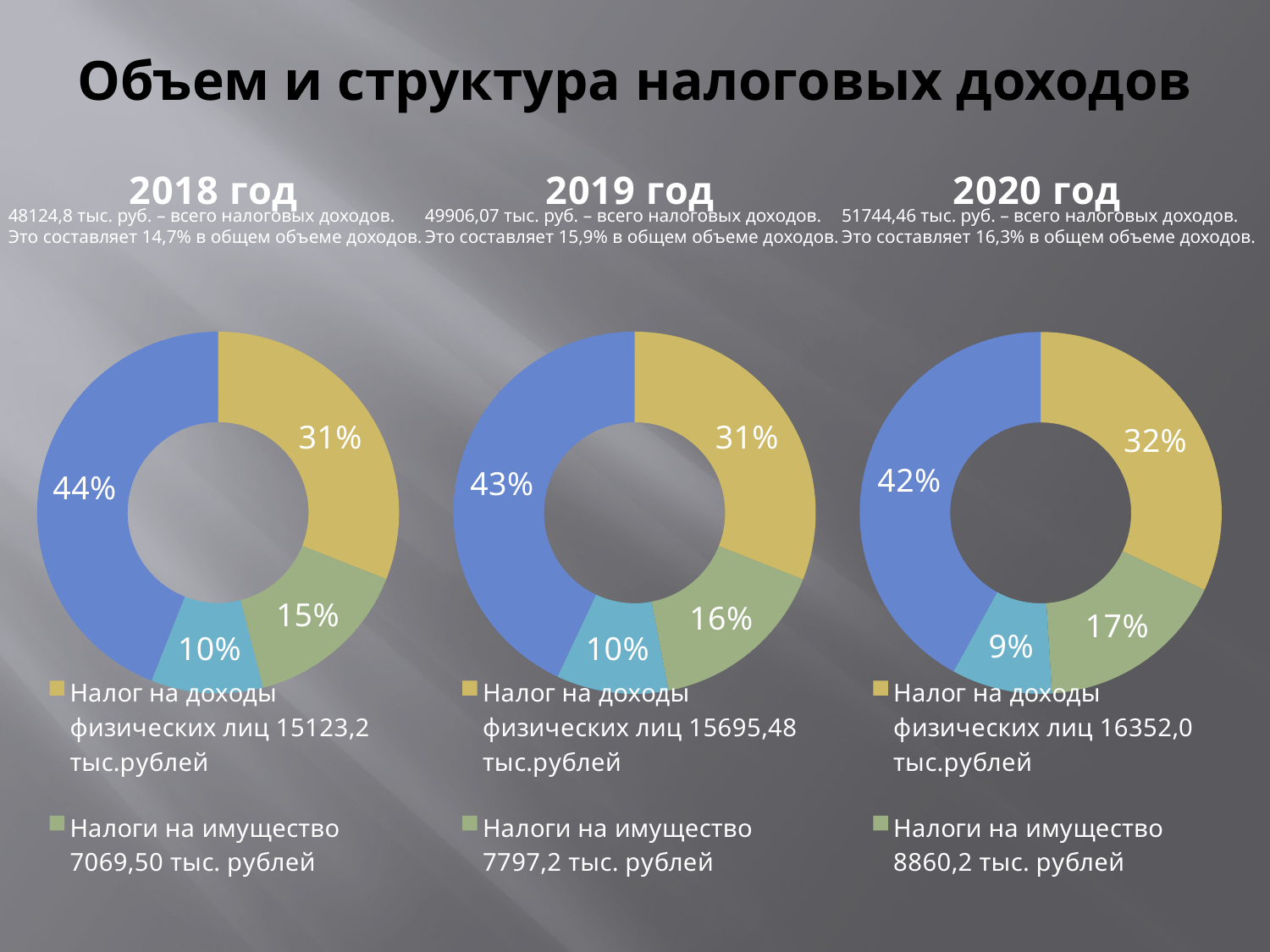
Across the 2018, 2019 and 2020 charts, does the share of Налоги на имущество rise or fall? Rises In the 2020 год chart, which is larger: Налог на доходы физических лиц or Налоги на имущество? Налог на доходы физических лиц In the 2018 год chart, what is the difference in percentage points between Налог на доходы физических лиц and Налоги на имущество? 16 percentage points In the 2020 год chart, what share does Налог на доходы физических лиц have? 32% How many doughnut charts are shown on the slide? 3 In the 2018 год chart, what share does Налог на доходы физических лиц have? 31% How many slices does the 2019 год chart have? 4 In the 2019 год chart, what share does Налоги на имущество have? 16% In the 2020 год chart, what is the percentage of the smallest slice? 9% In the 2018 год chart, what is the percentage of the smallest slice? 10% What kind of chart is used for the 2019 год data? Doughnut (pie) chart In the 2020 год chart, what is the percentage of the largest slice? 42%